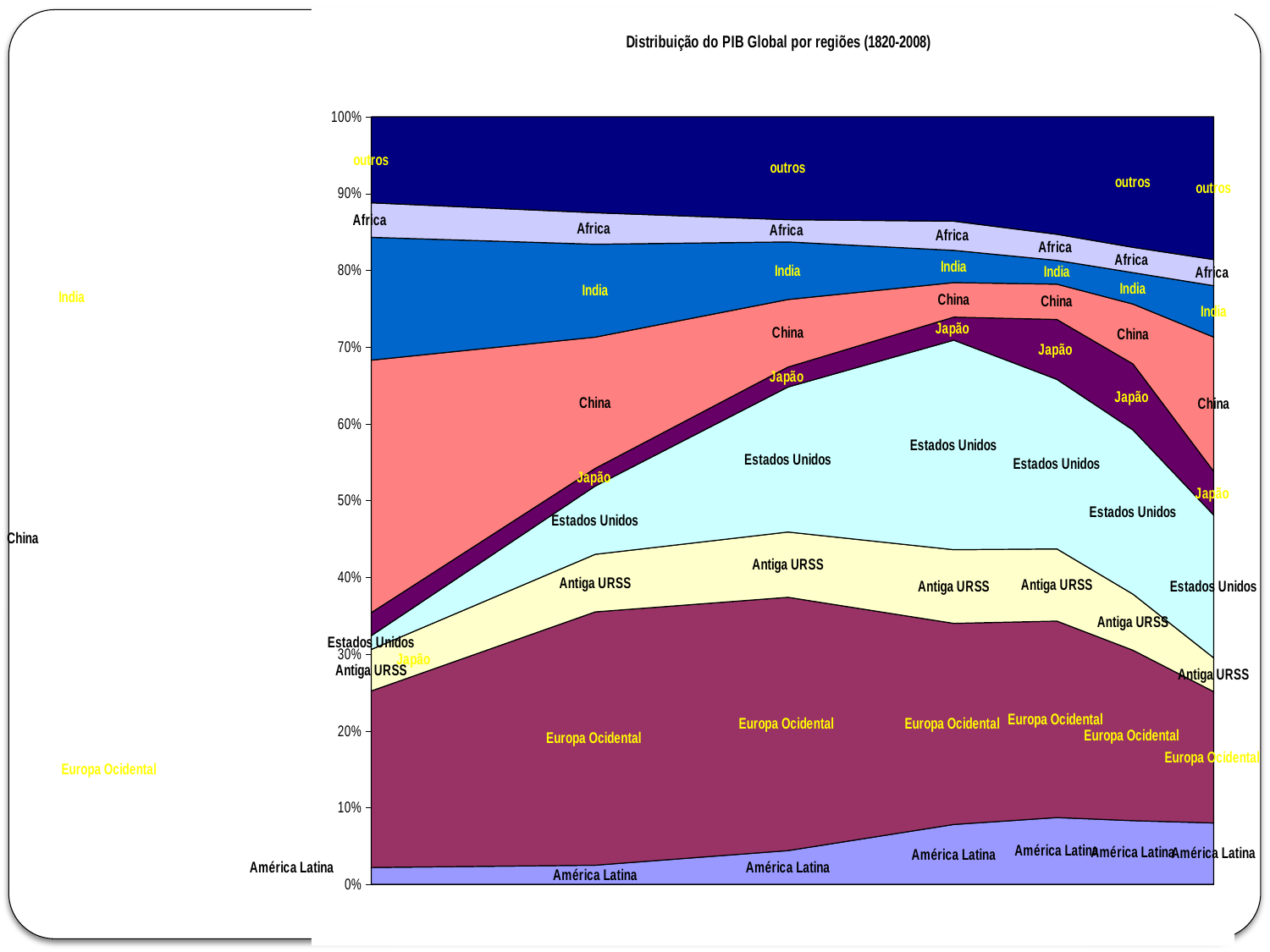
At the left edge of the chart, which region has the largest share of global GDP? China What kind of chart is shown on the slide? Stacked area chart What is the title of the chart? Distribuição do PIB Global por regiões (1820-2008) How many regions (series) are stacked in the chart? 9 How does the share of India change from the left edge to the right edge of the chart? It falls At the right edge of the chart, which is larger: the share of Europa Ocidental or the share of Antiga URSS? Europa Ocidental At the left edge of the chart, is the cumulative top of the Europa Ocidental band greater or less than 30%? less Which region forms the bottom band of the stacked area chart? América Latina At the left edge of the chart, which is larger: the share of China or the share of Estados Unidos? China At the left edge of the chart, which is larger: the share of India or the share of Africa? India How does the share of China change from the left edge to the middle of the chart? It falls How does the share of Estados Unidos change from the left edge to the middle of the chart? It rises